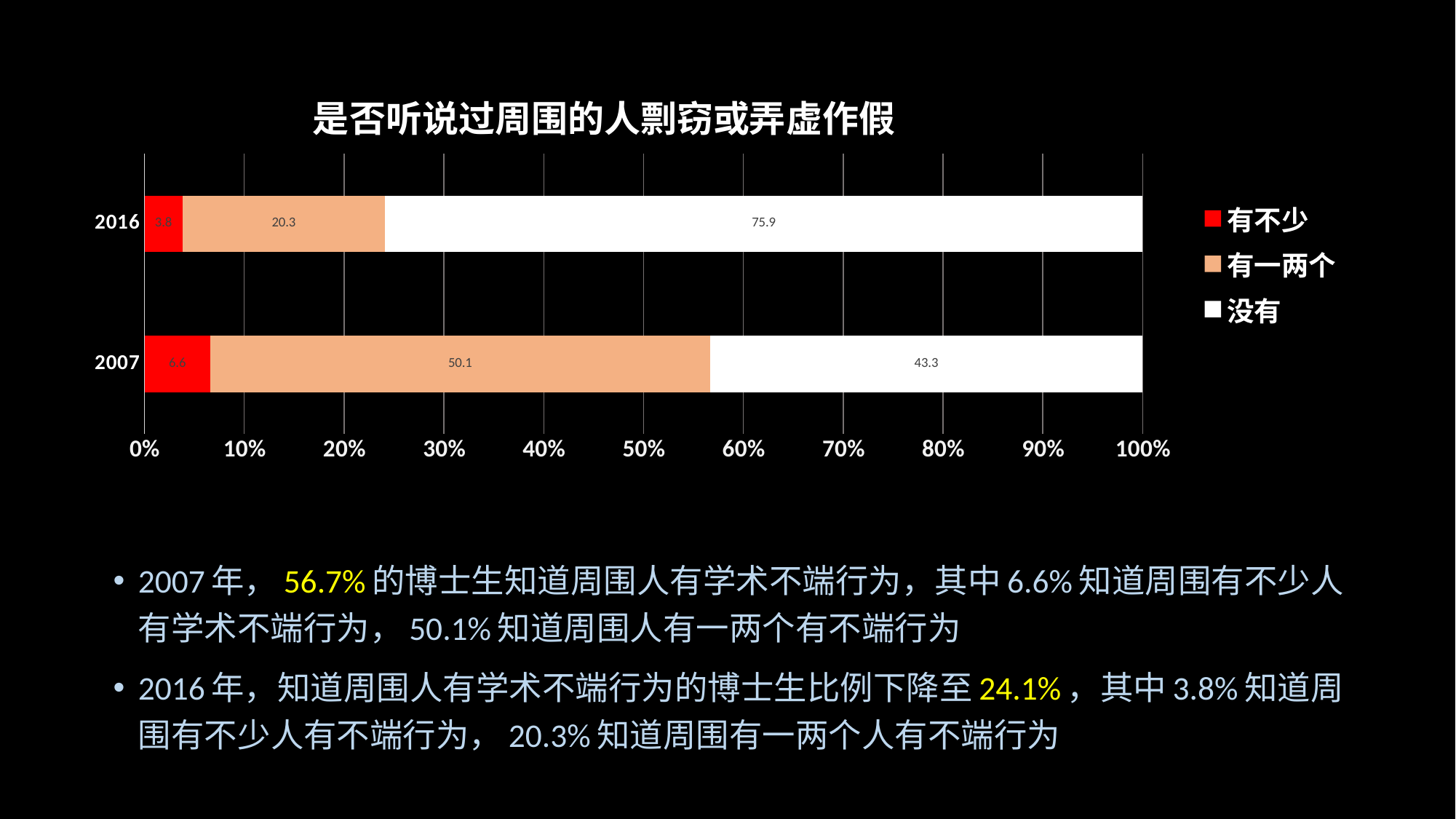
What is the difference between the 有不少 values for 2007 and 2016? 2.8 What is the value for 没有 in 2007? 43.3 What is the value for 有不少 in 2016? 3.8 What is the title of the chart? 是否听说过周围的人剽窃或弄虚作假 Which year has the higher value for 有一两个? 2007 What is the value for 没有 in 2016? 75.9 Which year has the higher value for 没有? 2016 What is the value for 有一两个 in 2007? 50.1 What is the difference between the 有一两个 values for 2007 and 2016? 29.8 How many categories (years) are shown on the chart? 2 How many series does the legend list? 3 What kind of chart is shown on the slide? Stacked bar chart